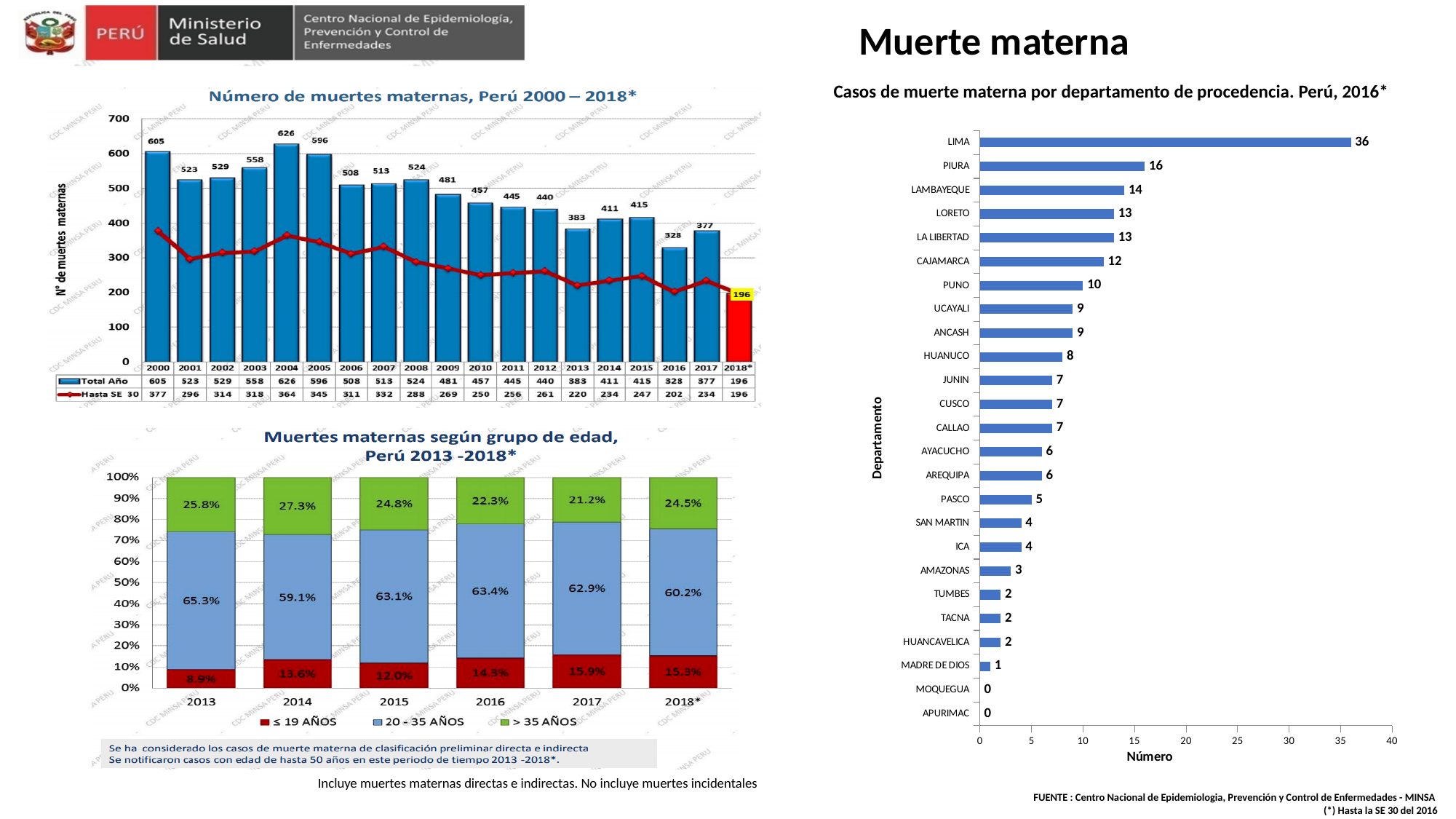
In the chart 'Número de muertes maternas, Perú 2000 – 2018*', what is the difference between the Total Año values for 2000 and 2017? 228 In the chart 'Casos de muerte materna por departamento de procedencia. Perú, 2016*', what is the value for PIURA? 16 In the chart 'Número de muertes maternas, Perú 2000 – 2018*', which year has the highest Total Año value? 2004 In the chart 'Muertes maternas según grupo de edad, Perú 2013 -2018*', which year has the lowest share for the ≤ 19 AÑOS group? 2013 In the chart 'Número de muertes maternas, Perú 2000 – 2018*', what is the Hasta SE 30 value for 2016? 202 In the chart 'Muertes maternas según grupo de edad, Perú 2013 -2018*', what is the share of the ≤ 19 AÑOS group in 2017? 15.9% In the chart 'Casos de muerte materna por departamento de procedencia. Perú, 2016*', which department has the highest value? LIMA In the chart 'Casos de muerte materna por departamento de procedencia. Perú, 2016*', what is the difference between the values for LIMA and LAMBAYEQUE? 22 What kind of chart is 'Casos de muerte materna por departamento de procedencia. Perú, 2016*'? Bar chart In the chart 'Muertes maternas según grupo de edad, Perú 2013 -2018*', what is the share of the > 35 AÑOS group in 2014? 27.3% In the chart 'Número de muertes maternas, Perú 2000 – 2018*', how many series does the legend list? 2 In the chart 'Número de muertes maternas, Perú 2000 – 2018*', what is the Total Año value for 2004? 626